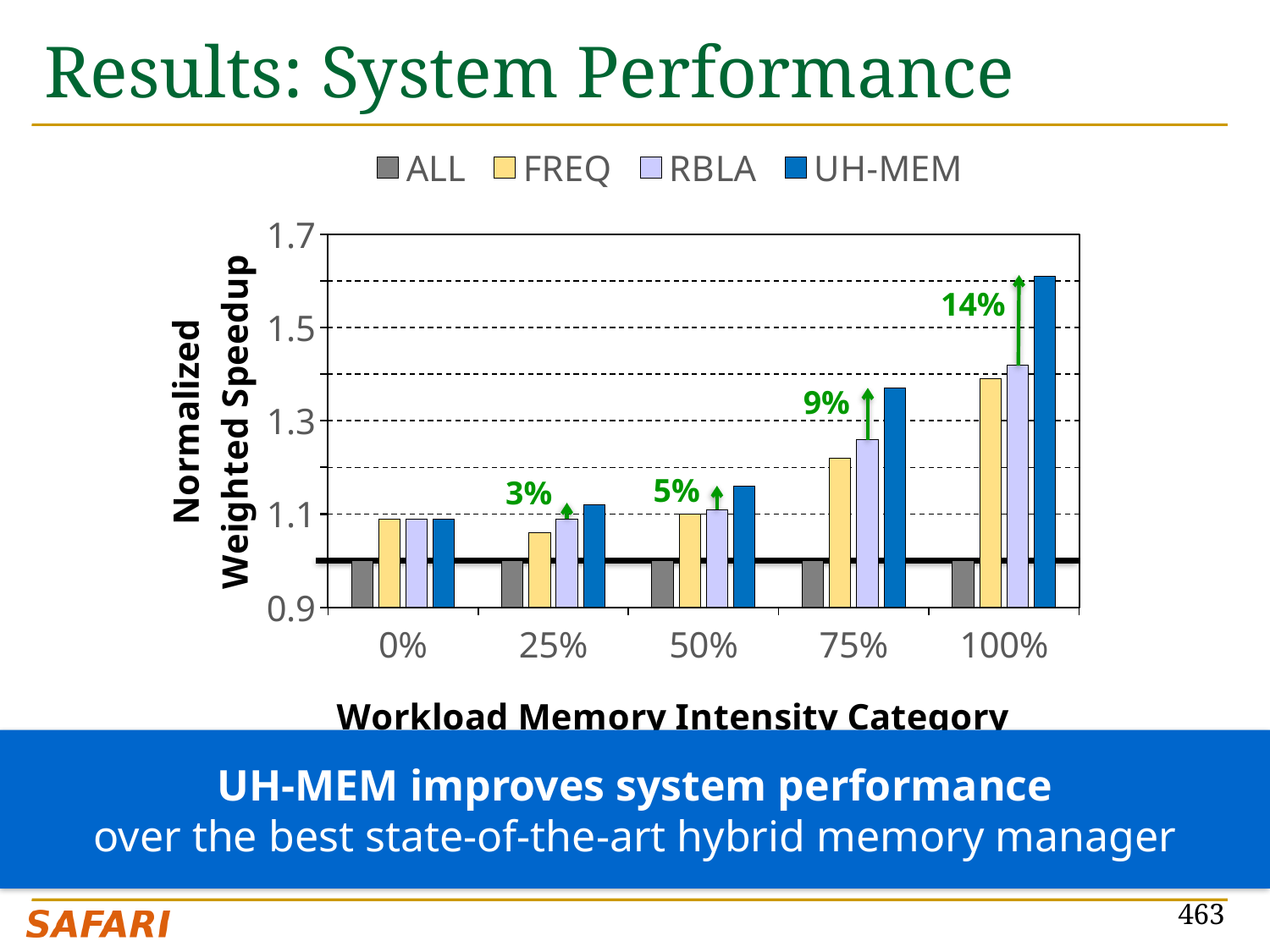
Is the FREQ value for the 25% category greater or less than 1.1? less In the 100% category, which is larger, the UH-MEM bar or the RBLA bar? UH-MEM What improvement percentage is annotated above the 100% category? 14% Is the RBLA value for the 50% category greater or less than 1.3? less Which workload memory intensity category has the highest UH-MEM normalized weighted speedup? 100% Is the UH-MEM value for the 100% category greater or less than 1.5? greater How many workload memory intensity categories are shown on the x axis? 5 Which workload memory intensity category has the lowest UH-MEM normalized weighted speedup? 0% What kind of chart is shown on the slide? bar chart Do the UH-MEM values rise or fall as the workload memory intensity category increases from 0% to 100%? rise How many series does the legend list? 4